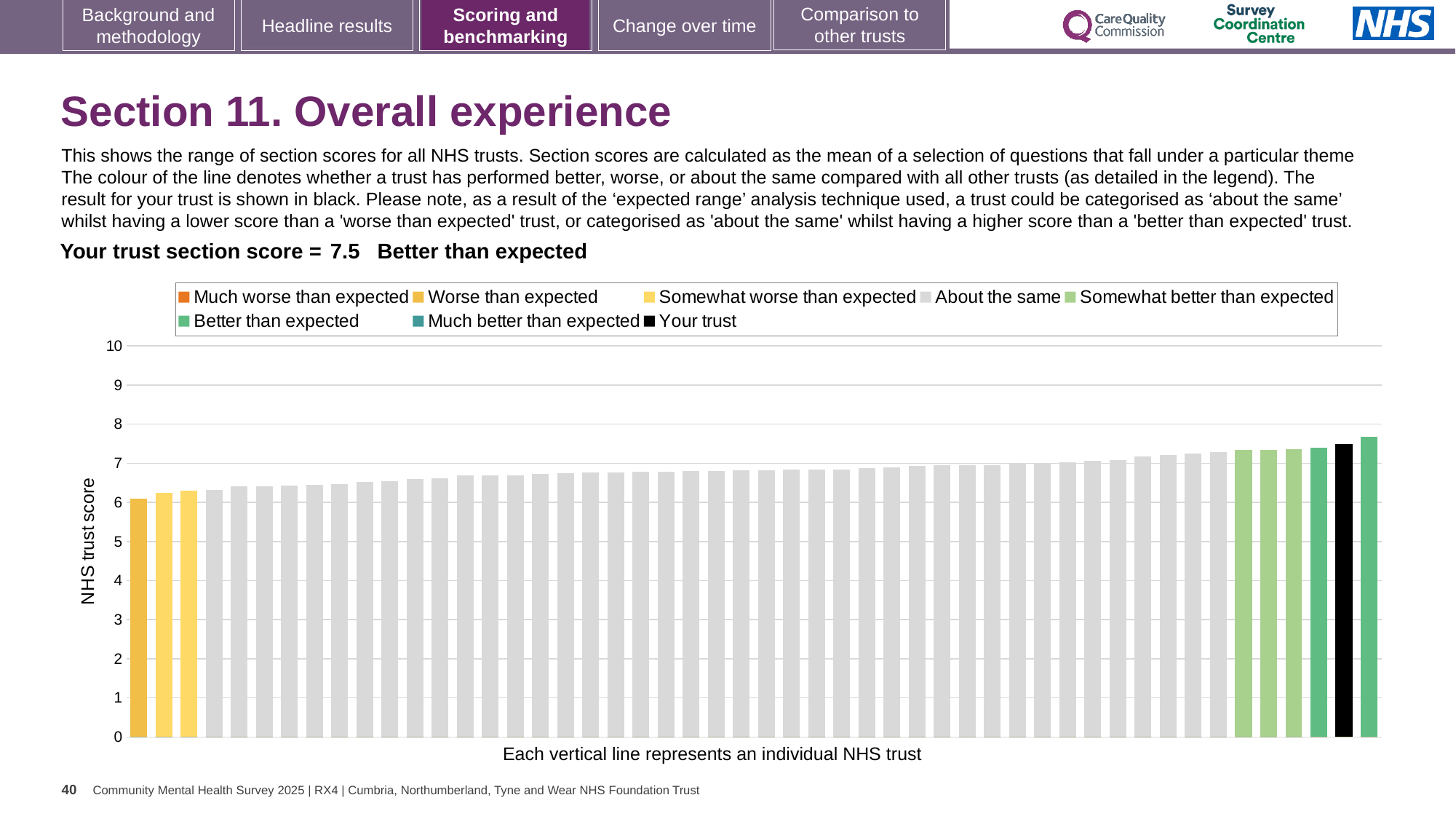
What is the label on the vertical axis of the chart? NHS trust score Which bar is larger, the leftmost bar or the rightmost bar? the rightmost bar What colour is the bar representing your trust? black How many entries does the chart legend list? 8 Is the value of the leftmost bar in the chart greater or less than 7? less What kind of chart is shown on the slide? bar chart How is your trust's section score categorised on the slide? Better than expected Do the bar values rise or fall from left to right across the chart? rise How many bars are coloured light green (somewhat better than expected)? 3 What is the section score for your trust shown on the slide? 7.5 Is the value of the black bar (your trust) greater or less than 7? greater Is the value of the tallest bar in the chart greater or less than 8? less